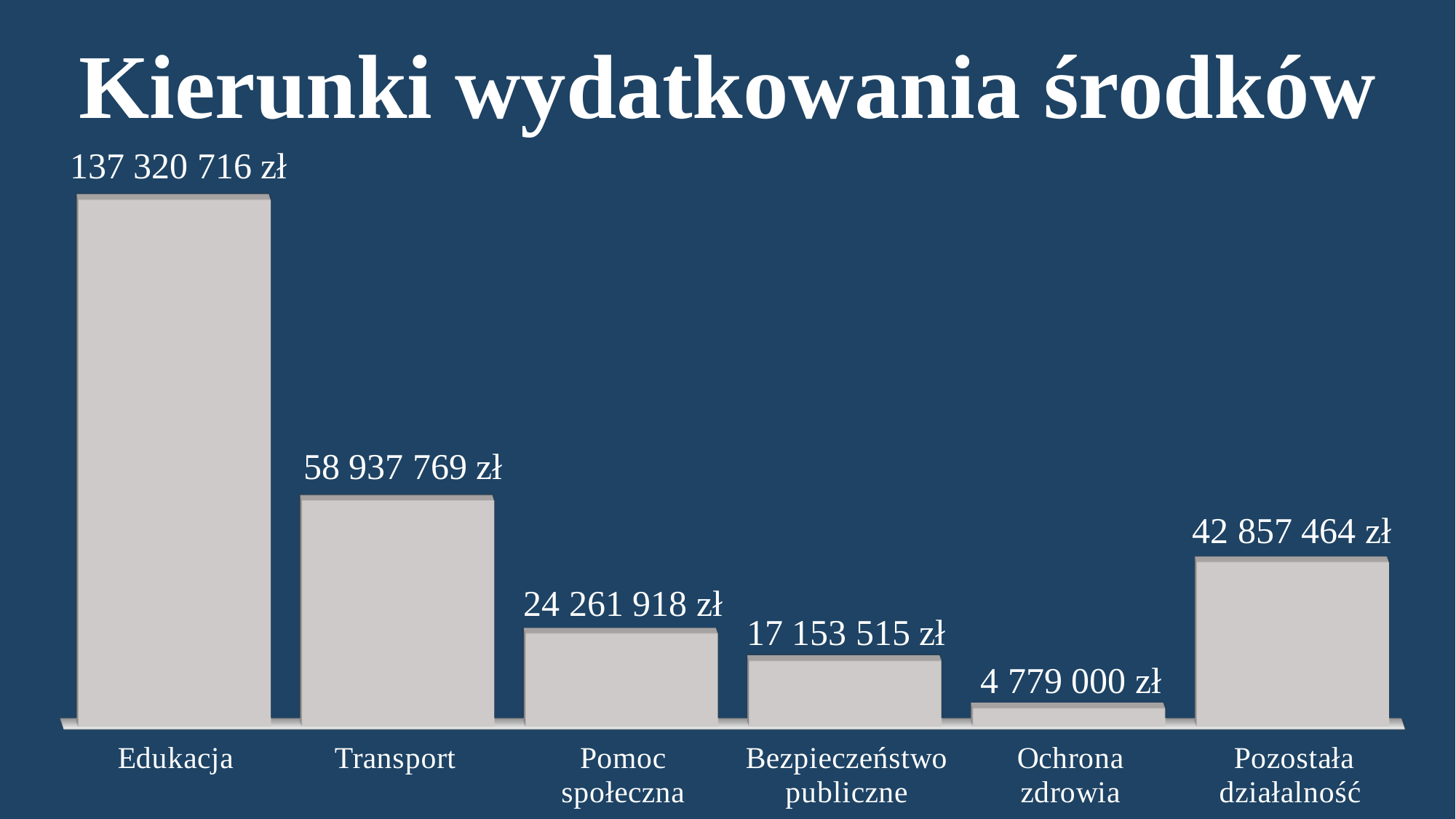
Which category has the lowest value? Ochrona zdrowia What is the title of the slide? Kierunki wydatkowania środków What is the difference between the values for Pomoc społeczna and Bezpieczeństwo publiczne? 7 108 403 zł What is the difference between the values for Edukacja and Transport? 78 382 947 zł What is the value for Pozostała działalność? 42 857 464 zł What is the value for Edukacja? 137 320 716 zł What is the value for Ochrona zdrowia? 4 779 000 zł Which is larger, the value for Pozostała działalność or the value for Pomoc społeczna? Pozostała działalność What kind of chart is shown on the slide? Bar chart Which category has the highest value? Edukacja How many categories are shown in the chart? 6 What is the value for Transport? 58 937 769 zł